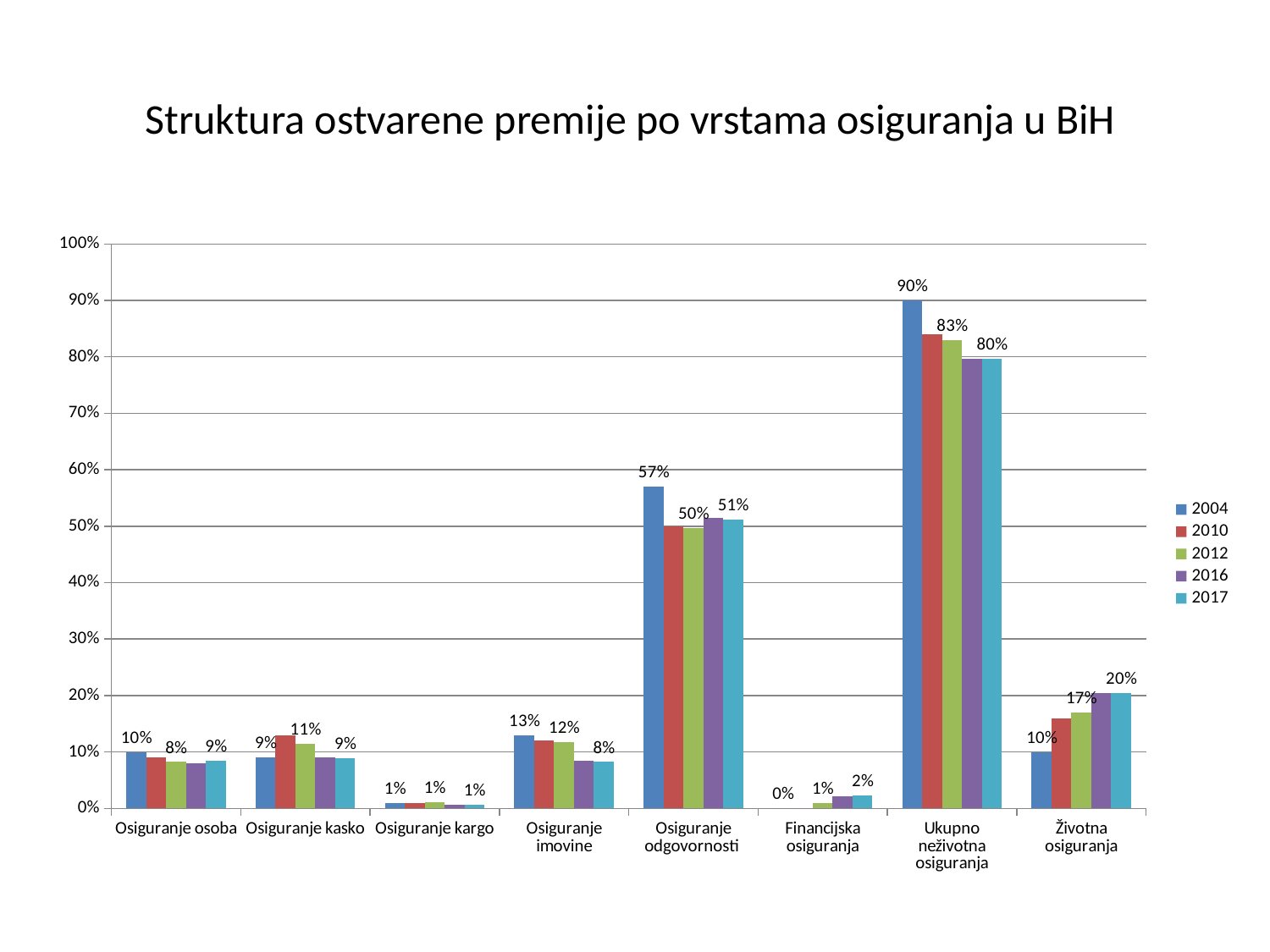
How many categories are shown on the x axis? 8 What is the value for Životna osiguranja in 2017? 20% What is the difference between the 2004 and 2017 values for Ukupno neživotna osiguranja? 10 percentage points What is the difference between the 2004 and 2012 values for Osiguranje odgovornosti? 7 percentage points What is the value for Ukupno neživotna osiguranja in 2004? 90% How many series does the legend list? 5 What is the value for Financijska osiguranja in 2017? 2% What type of chart is shown on the slide? Bar chart Which category has the highest value for 2004? Ukupno neživotna osiguranja What is the value for Osiguranje odgovornosti in 2012? 50% For Osiguranje imovine, which year has the larger value, 2004 or 2017? 2004 Is the 2010 value for Ukupno neživotna osiguranja greater or less than 80%? greater